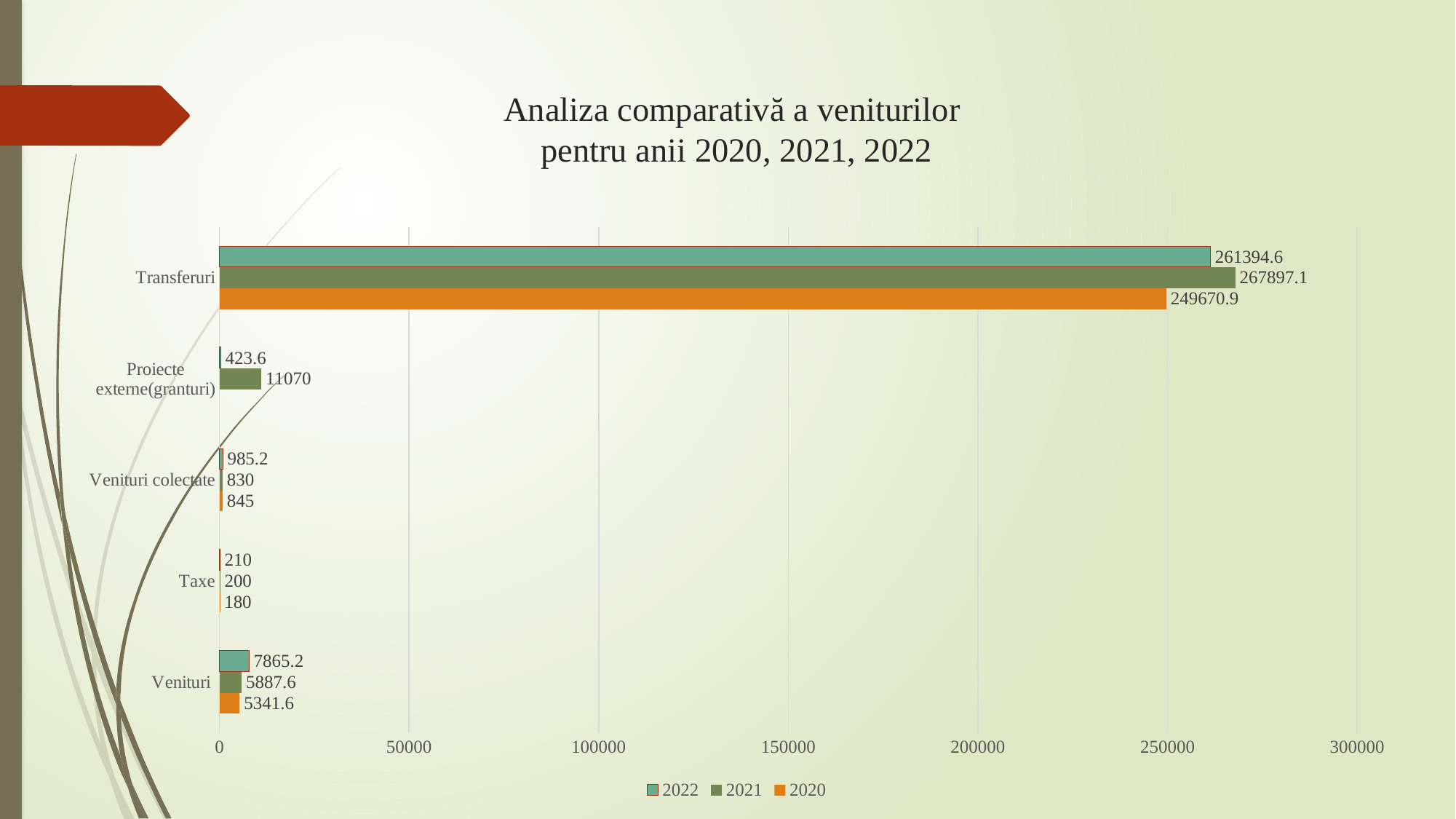
Which year has the highest value for Transferuri? 2021 What is the difference between the 2022 and 2021 values for Venituri? 1977.6 How many categories are shown on the vertical axis? 5 What is the value for Proiecte externe(granturi) in 2021? 11070 Is the 2020 value for Transferuri greater or less than 250000? less How many series does the legend list? 3 Which is larger for Venituri colectate: the 2021 value or the 2020 value? 2020 What is the value for Taxe in 2020? 180 Which year has the lowest value for Venituri? 2020 What is the value for Venituri in 2022? 7865.2 What type of chart is shown on the slide? Bar chart What is the value for Transferuri in 2021? 267897.1